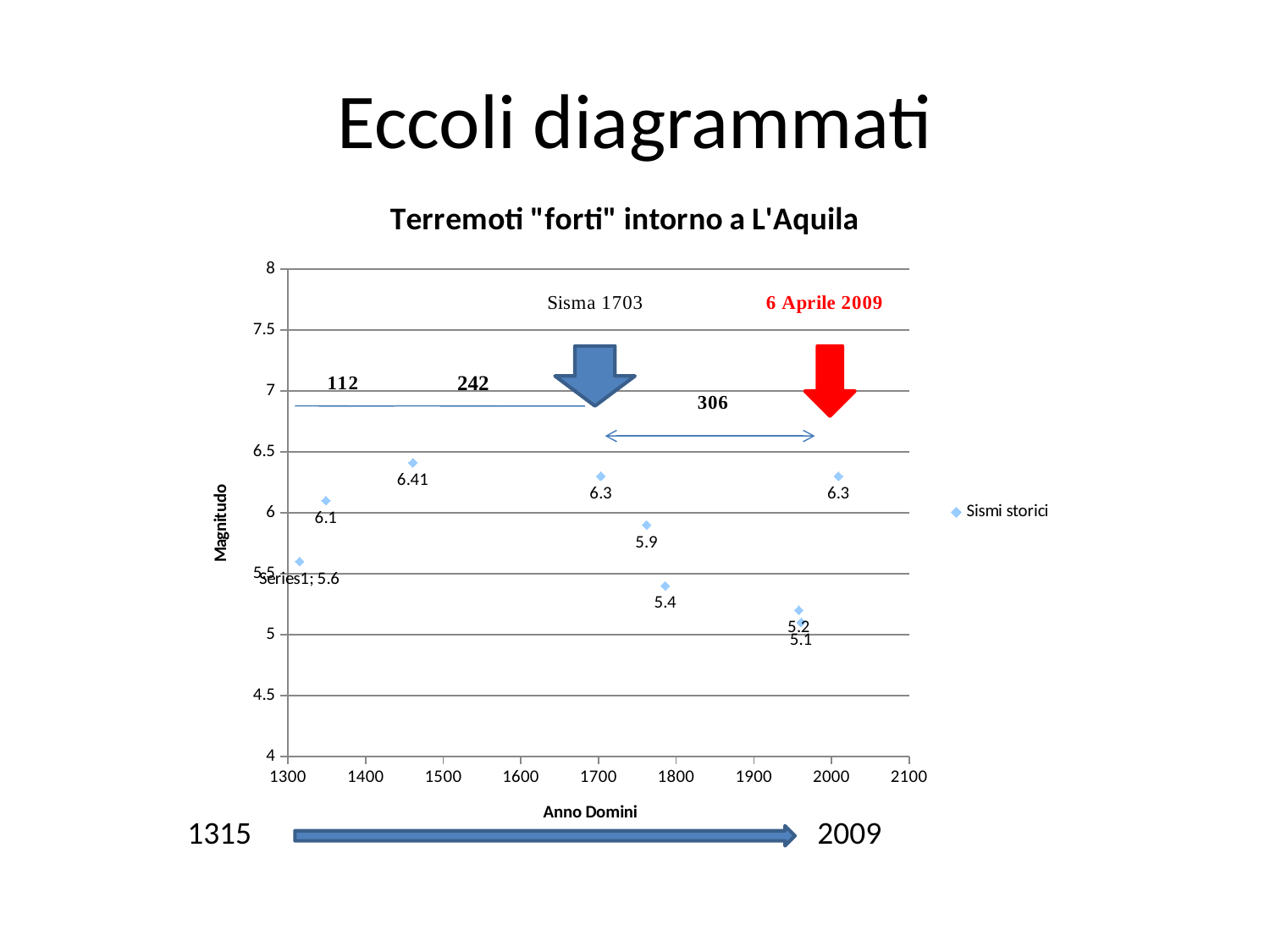
What is the highest magnitude value labelled in the chart? 6.41 How many data points are plotted in the chart? 9 What is the name of the series shown in the legend? Sismi storici What magnitude is labelled for the earthquake marked "Sisma 1703"? 6.3 How many series does the legend list? 1 Which is larger: the magnitude labelled 6.41 near the year 1460 or the magnitude labelled 6.3 near the year 1703? 6.41 What is the lowest magnitude value labelled in the chart? 5.1 What is the difference between the highest labelled magnitude (6.41) and the lowest labelled magnitude (5.1)? 1.31 What is the title of the chart? Terremoti "forti" intorno a L'Aquila What kind of chart is shown on the slide? scatter chart What magnitude is labelled for the earthquake marked "6 Aprile 2009"? 6.3 Is the highest plotted magnitude greater or less than 6.5? less